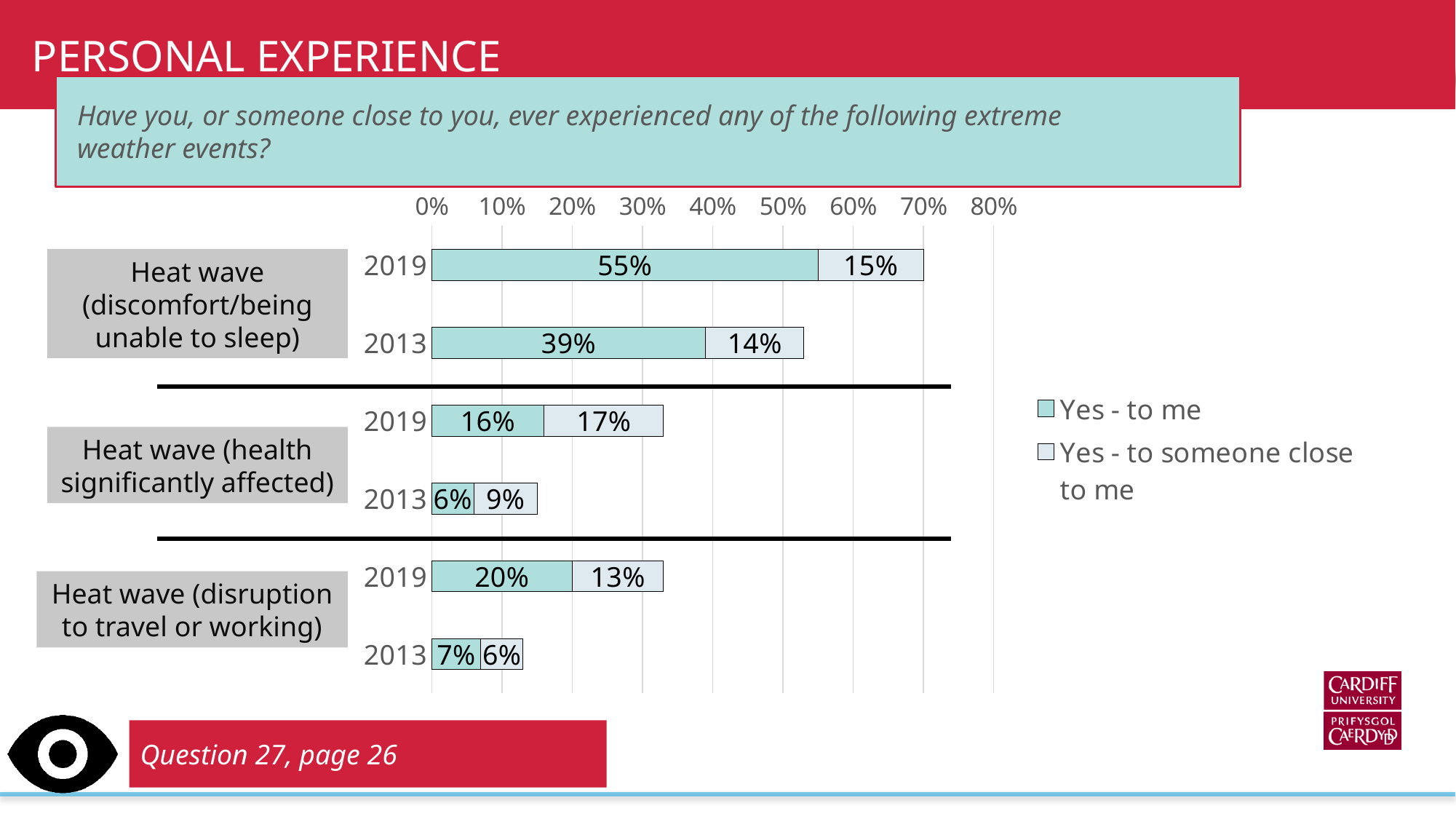
Which bar has the highest "Yes - to me" value? Heat wave (discomfort/being unable to sleep) 2019 Did the "Yes - to me" value for Heat wave (disruption to travel or working) rise or fall from 2013 to 2019? rise What kind of chart is shown on the slide? Stacked bar chart What percentage answered "Yes - to me" for Heat wave (disruption to travel or working) in 2013? 7% What is the total of the stacked bar for Heat wave (disruption to travel or working) in 2019? 33% What percentage answered "Yes - to me" for Heat wave (discomfort/being unable to sleep) in 2019? 55% What is the total of the stacked bar for Heat wave (discomfort/being unable to sleep) in 2019? 70% How many series does the legend list? 2 Is the "Yes - to me" value for Heat wave (health significantly affected) in 2019 larger or smaller than the "Yes - to someone close to me" value for the same bar? smaller Which bar has the lowest "Yes - to me" value? Heat wave (health significantly affected) 2013 What is the difference between the "Yes - to me" values for Heat wave (discomfort/being unable to sleep) in 2019 and 2013? 16 percentage points What percentage answered "Yes - to someone close to me" for Heat wave (health significantly affected) in 2013? 9%